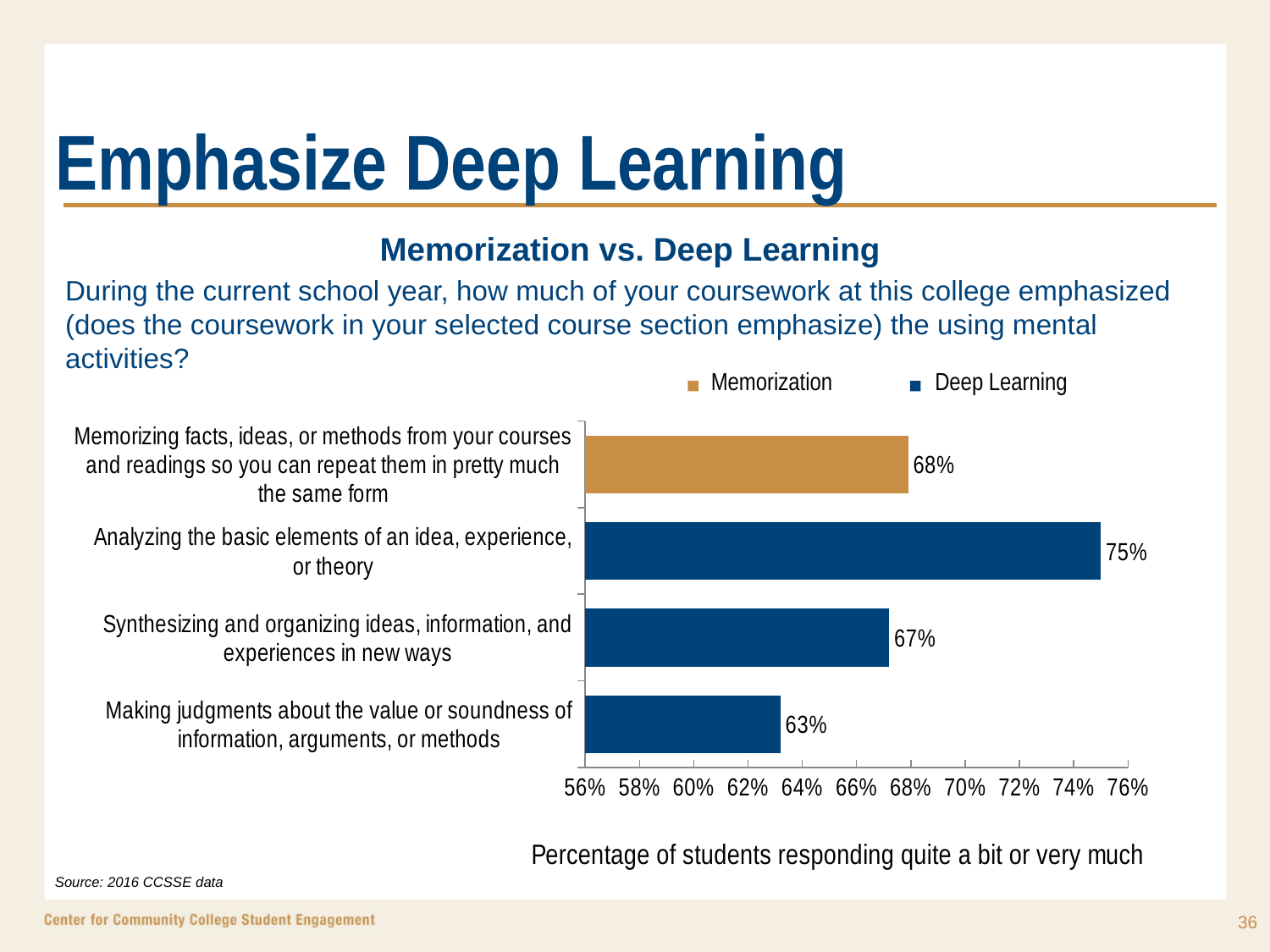
What is the title of the chart? Memorization vs. Deep Learning What is the difference between the value for "Analyzing the basic elements of an idea, experience, or theory" and the value for "Making judgments about the value or soundness of information, arguments, or methods"? 12% Which activity has the lowest percentage of students responding quite a bit or very much? Making judgments about the value or soundness of information, arguments, or methods What kind of chart is shown on the slide? Bar chart What is the value for "Synthesizing and organizing ideas, information, and experiences in new ways"? 67% What is the value for "Analyzing the basic elements of an idea, experience, or theory"? 75% Which is larger: the value for "Memorizing facts, ideas, or methods from your courses and readings so you can repeat them in pretty much the same form" or the value for "Synthesizing and organizing ideas, information, and experiences in new ways"? Memorizing facts, ideas, or methods from your courses and readings so you can repeat them in pretty much the same form Which activity has the highest percentage of students responding quite a bit or very much? Analyzing the basic elements of an idea, experience, or theory What percentage of students responded quite a bit or very much for "Memorizing facts, ideas, or methods from your courses and readings so you can repeat them in pretty much the same form"? 68% What is the value for "Making judgments about the value or soundness of information, arguments, or methods"? 63% How many series does the legend list? 2 How many activities (categories) are shown in the chart? 4